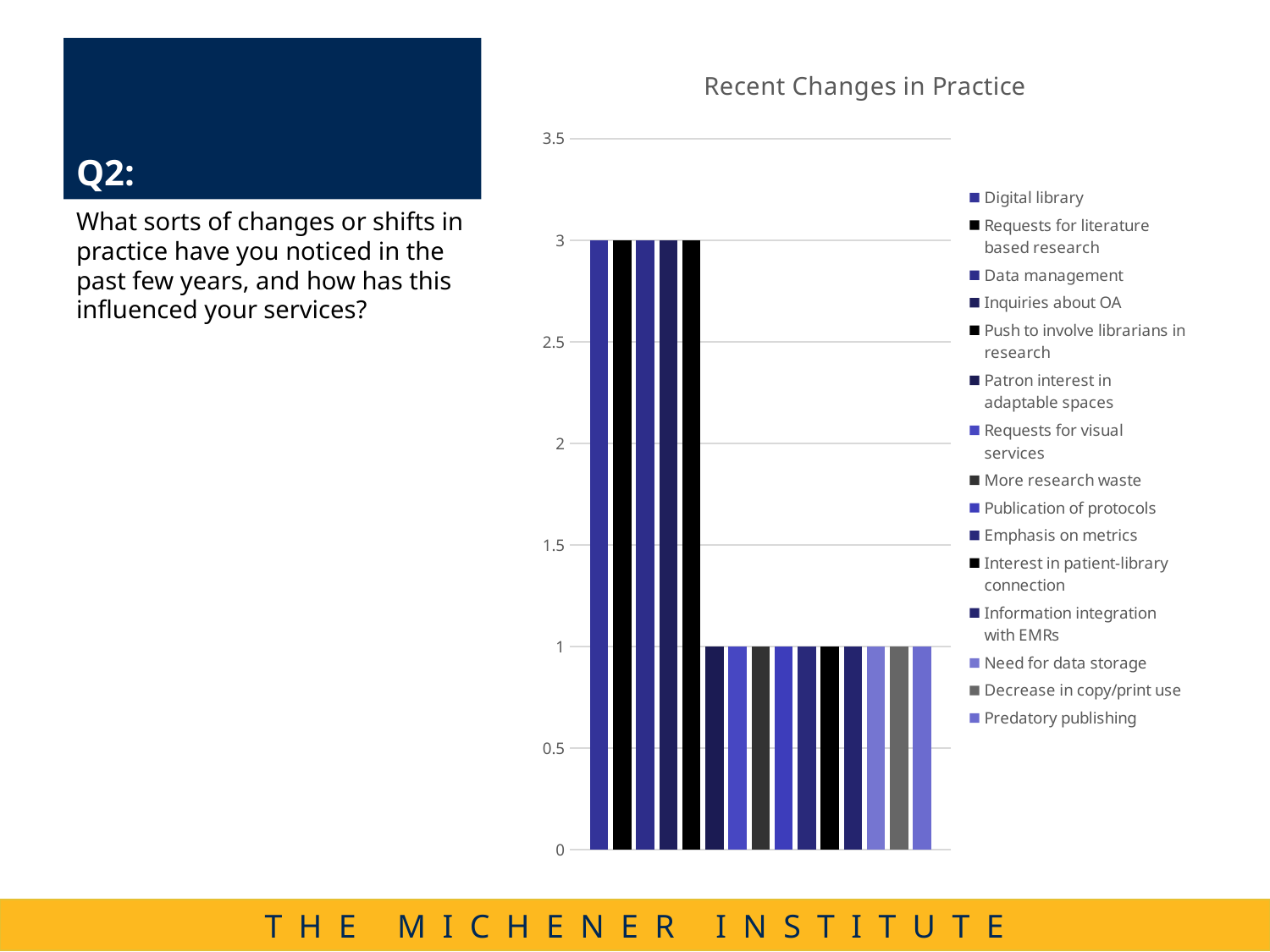
Do the bar heights rise or fall moving from left to right across the chart? fall How many bars are plotted in the chart? 15 Is the value for Requests for literature based research greater or less than 2? greater What is the highest value shown on the vertical axis? 3.5 Which is larger, the value for Inquiries about OA or the value for More research waste? Inquiries about OA What is the value for Push to involve librarians in research? 3 What is the value for Predatory publishing? 1 What is the value for Digital library? 3 What is the title of the chart? Recent Changes in Practice What kind of chart is shown on the slide? bar chart How many series does the chart's legend list? 15 What is the difference between the value for Data management and the value for Need for data storage? 2